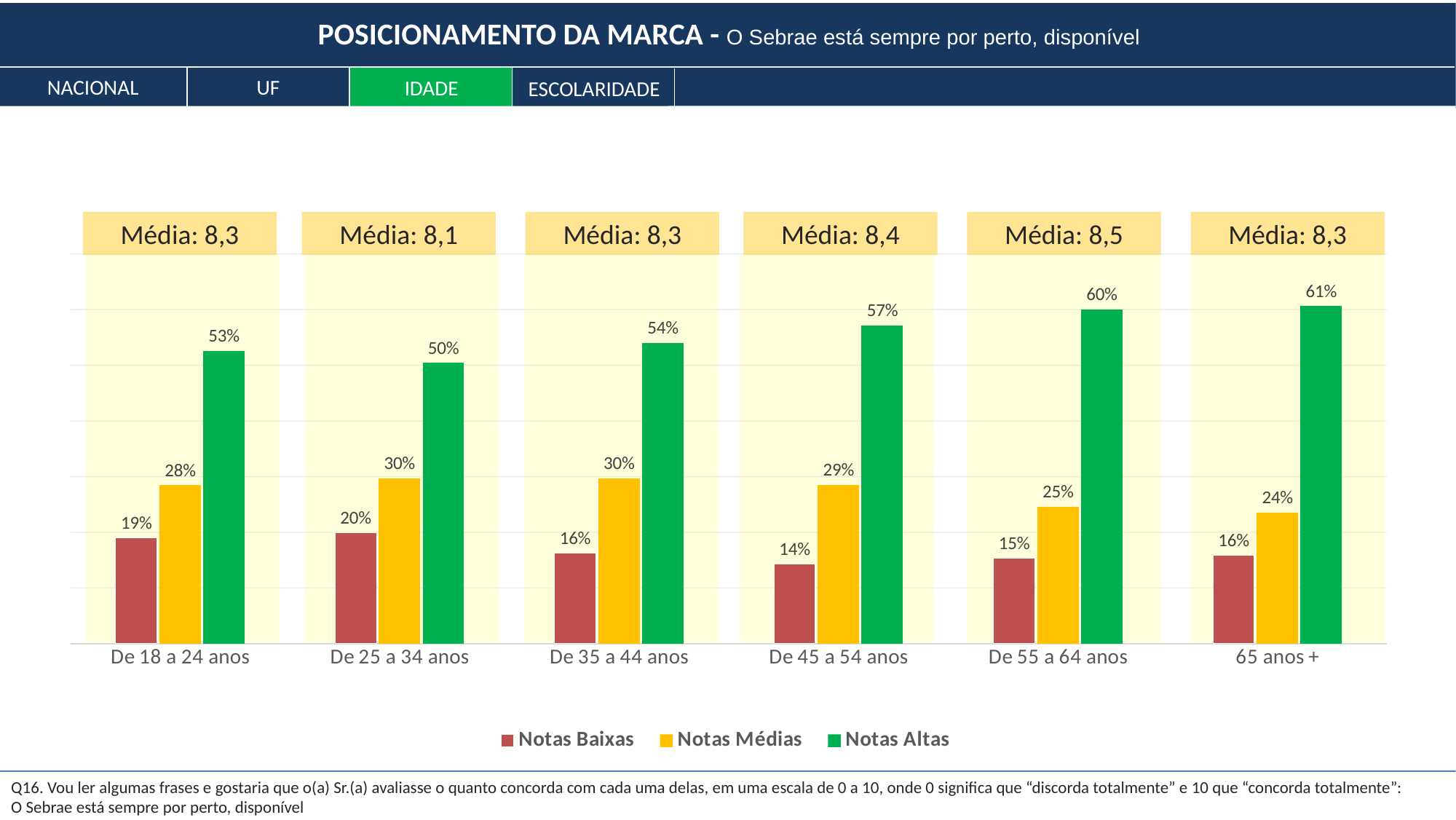
What is the difference between Notas Altas and Notas Médias for the 'De 18 a 24 anos' age group? 25 percentage points Which age group has the highest Notas Altas value? 65 anos + What colour represents Notas Altas in the legend? Green What is the Média shown for the 'De 55 a 64 anos' age group? 8,5 What kind of chart is shown on the slide? Bar chart Which age group has the lowest Notas Baixas value? De 45 a 54 anos Which is larger for the 'De 55 a 64 anos' group: Notas Médias or Notas Baixas? Notas Médias How many age groups are shown on the x axis? 6 How many series does the legend list? 3 Which age group has the lowest Média value? De 25 a 34 anos What is the value of Notas Altas for the 'De 45 a 54 anos' age group? 57% What is the value of Notas Baixas for the 'De 25 a 34 anos' age group? 20%